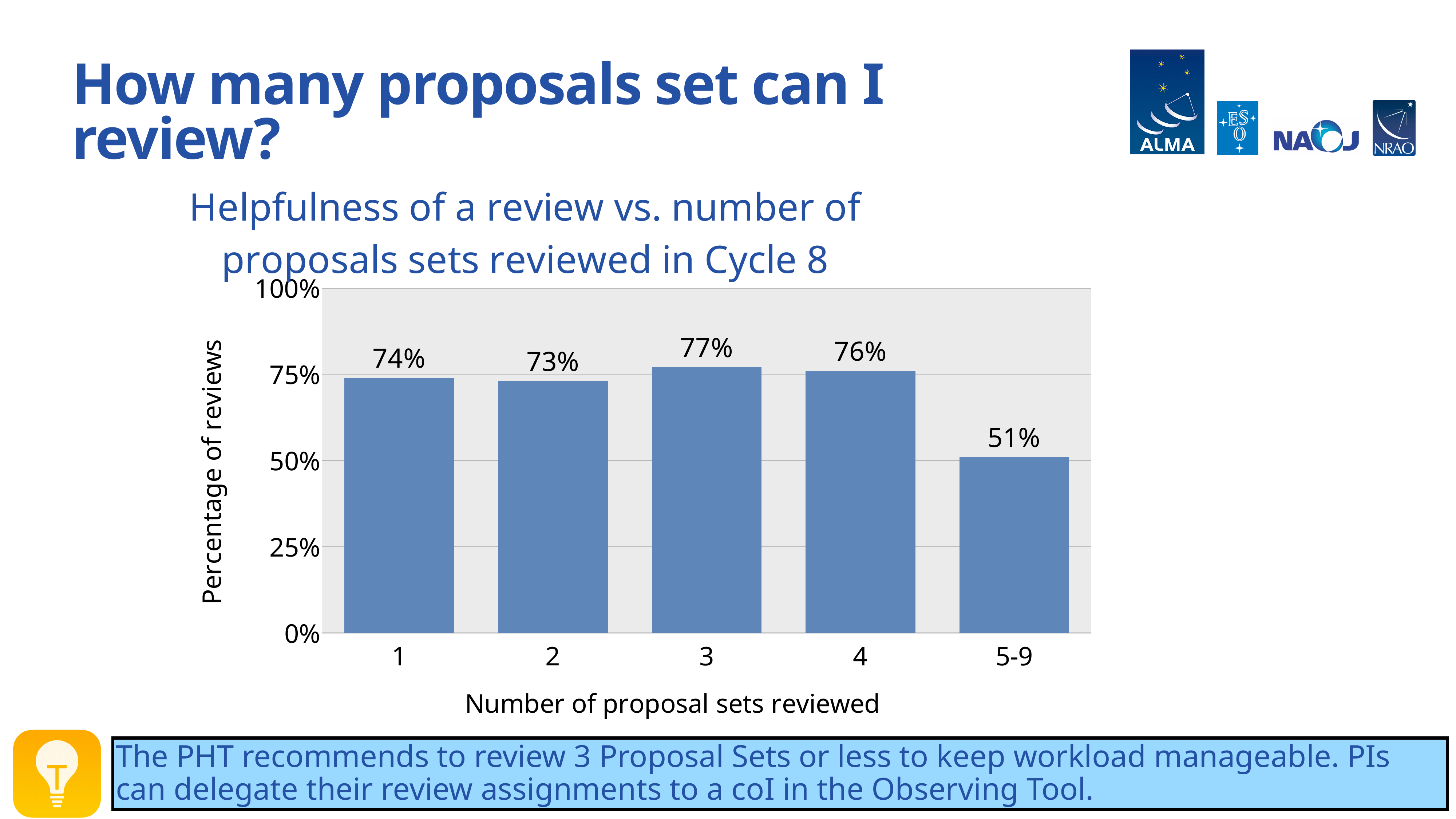
What is the difference in percentage of reviews between 1 proposal set and 2 proposal sets reviewed? 1% Is the value for 5-9 proposal sets reviewed greater or less than 75%? less What is the label of the y axis of the chart? Percentage of reviews What percentage of reviews is shown for 3 proposal sets reviewed? 77% How many categories are shown on the x axis of the chart? 5 Which category of number of proposal sets reviewed has the highest percentage of reviews? 3 Which has a higher percentage of reviews: 4 proposal sets reviewed or 5-9 proposal sets reviewed? 4 What percentage of reviews is shown for the 5-9 proposal sets reviewed category? 51% What kind of chart is shown on the slide? bar chart Which category of number of proposal sets reviewed has the lowest percentage of reviews? 5-9 What percentage of reviews is shown for 1 proposal set reviewed? 74% What is the difference in percentage of reviews between 3 proposal sets and 5-9 proposal sets reviewed? 26%